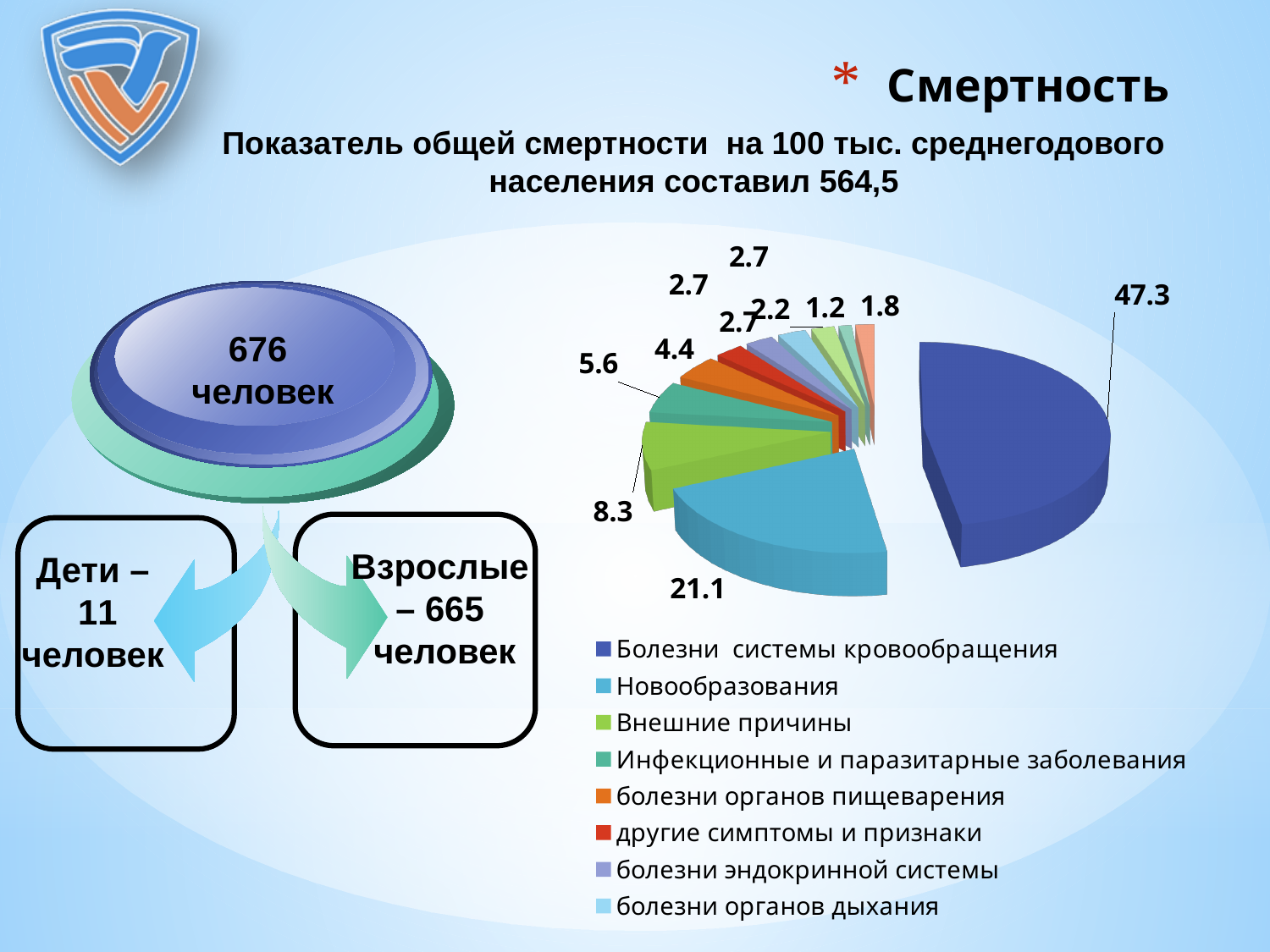
What is the difference between the values for Болезни системы кровообращения and Новообразования? 26.2 What is the value shown for Болезни системы кровообращения in the pie chart? 47.3 What is the value shown for Новообразования in the pie chart? 21.1 How many entries does the legend of the pie chart list? 8 What colour is the slice for Болезни системы кровообращения? Dark blue What is the value shown for Внешние причины in the pie chart? 8.3 What is the difference between the values for Внешние причины and Инфекционные и паразитарные заболевания? 2.7 What kind of chart is shown on the slide? Pie chart What is the value shown for Инфекционные и паразитарные заболевания in the pie chart? 5.6 What is the value shown for болезни органов пищеварения in the pie chart? 4.4 Which is larger in the pie chart: Новообразования or Внешние причины? Новообразования Which category has the largest slice in the pie chart? Болезни системы кровообращения